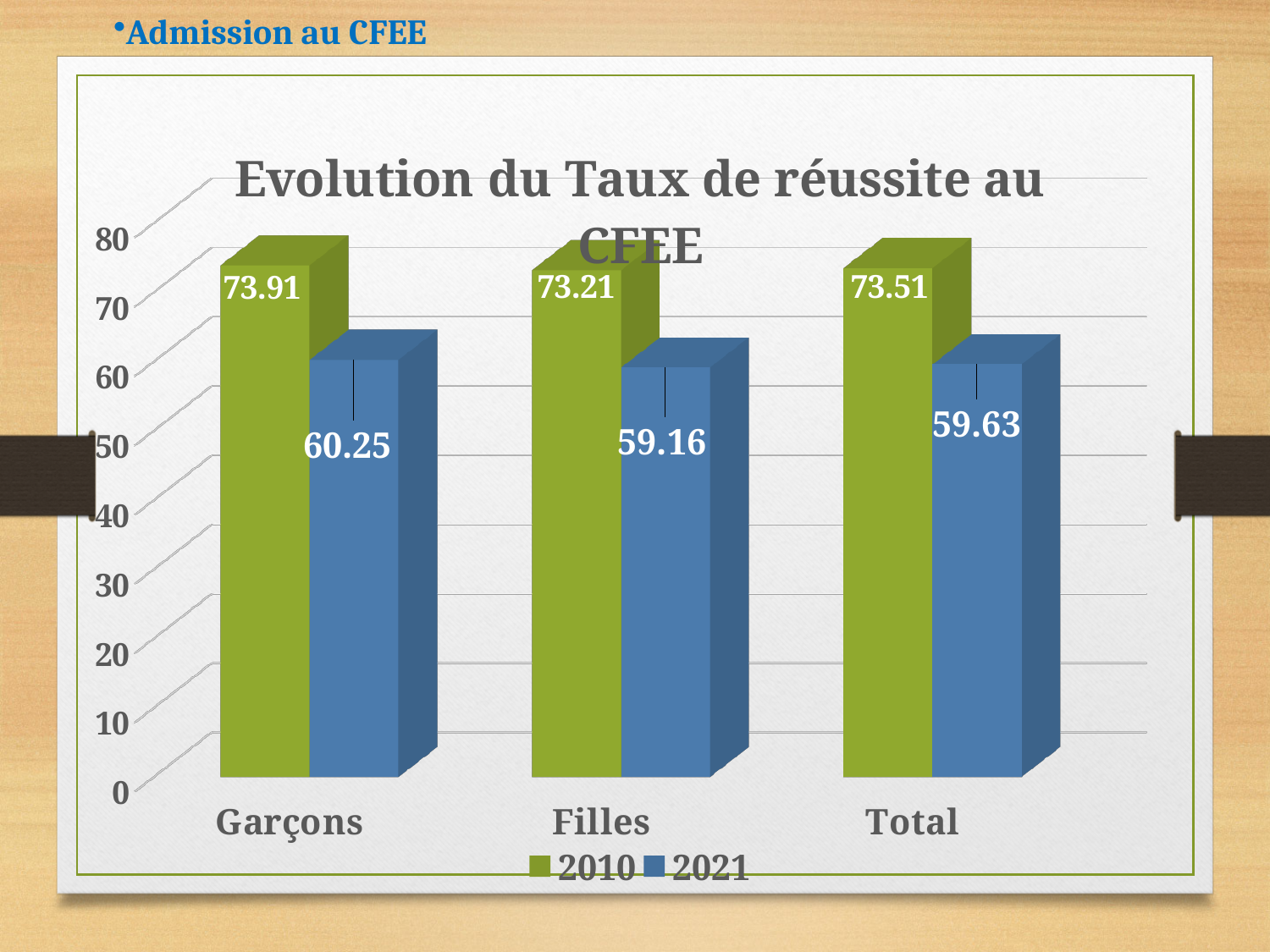
What kind of chart is shown on the slide? Bar chart How many series does the legend list? 2 Which category has the highest value in the 2010 series? Garçons What is the value for Total in 2021? 59.63 Which category has the lowest value in the 2021 series? Filles What is the value for Garçons in 2010? 73.91 What is the difference between the 2010 and 2021 values for Garçons? 13.66 What is the value for Filles in 2021? 59.16 What is the value for Filles in 2010? 73.21 Which is larger for Total: the 2010 value or the 2021 value? 2010 How many categories are shown on the x axis? 3 What is the title of the chart? Evolution du Taux de réussite au CFEE